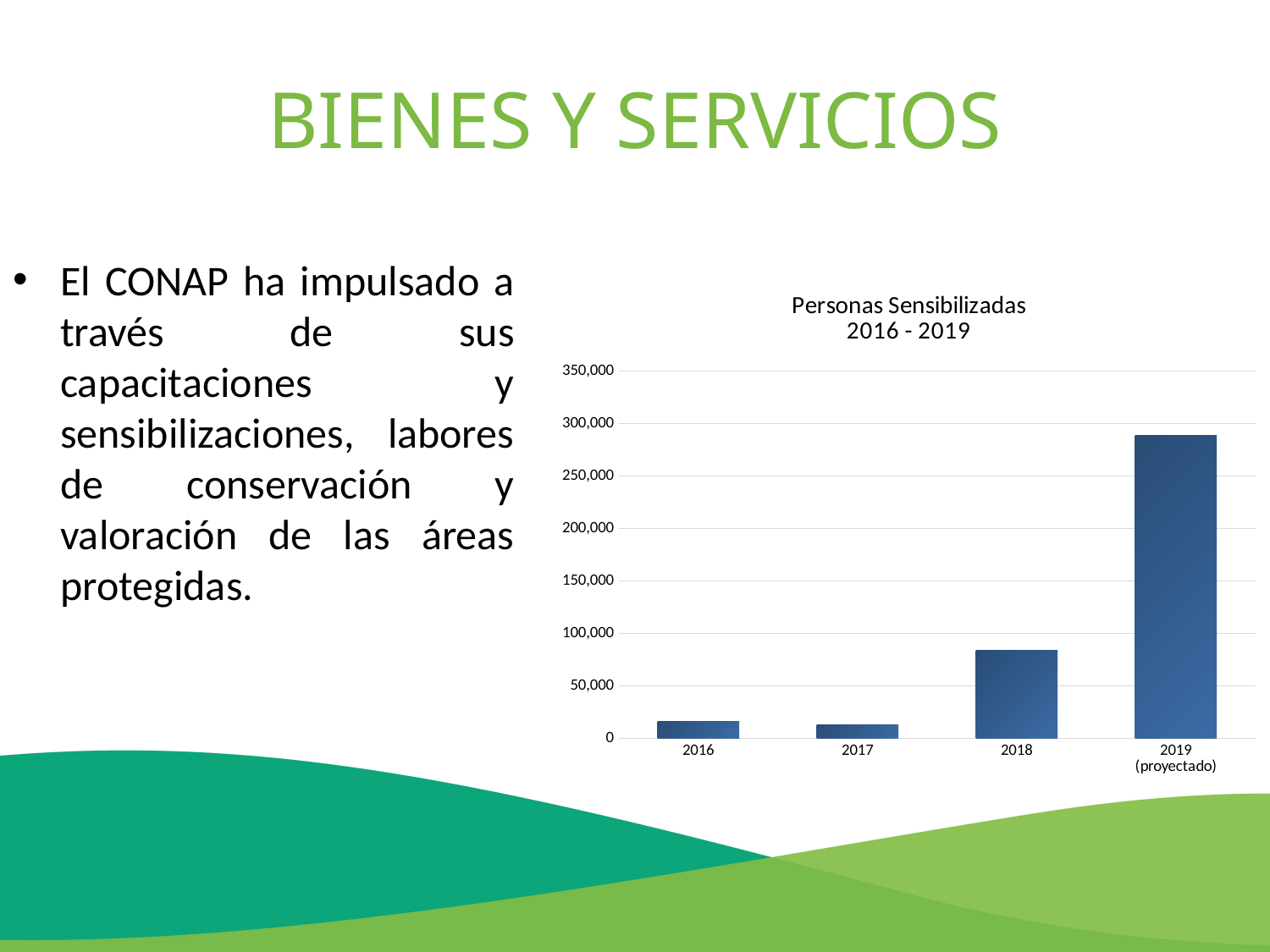
How many categories (years) are shown on the x axis of the chart? 4 Is the value for 2019 (proyectado) greater or less than 300,000? less Is the value for 2019 (proyectado) greater or less than 250,000? greater Which year has the highest value in the chart? 2019 (proyectado) What kind of chart is shown on the slide? bar chart Is the value for 2018 greater or less than 100,000? less Do the values rise or fall from 2017 to 2019 (proyectado)? rise What is the title of the chart? Personas Sensibilizadas 2016 - 2019 Which is larger, the value for 2018 or the value for 2019 (proyectado)? 2019 (proyectado)